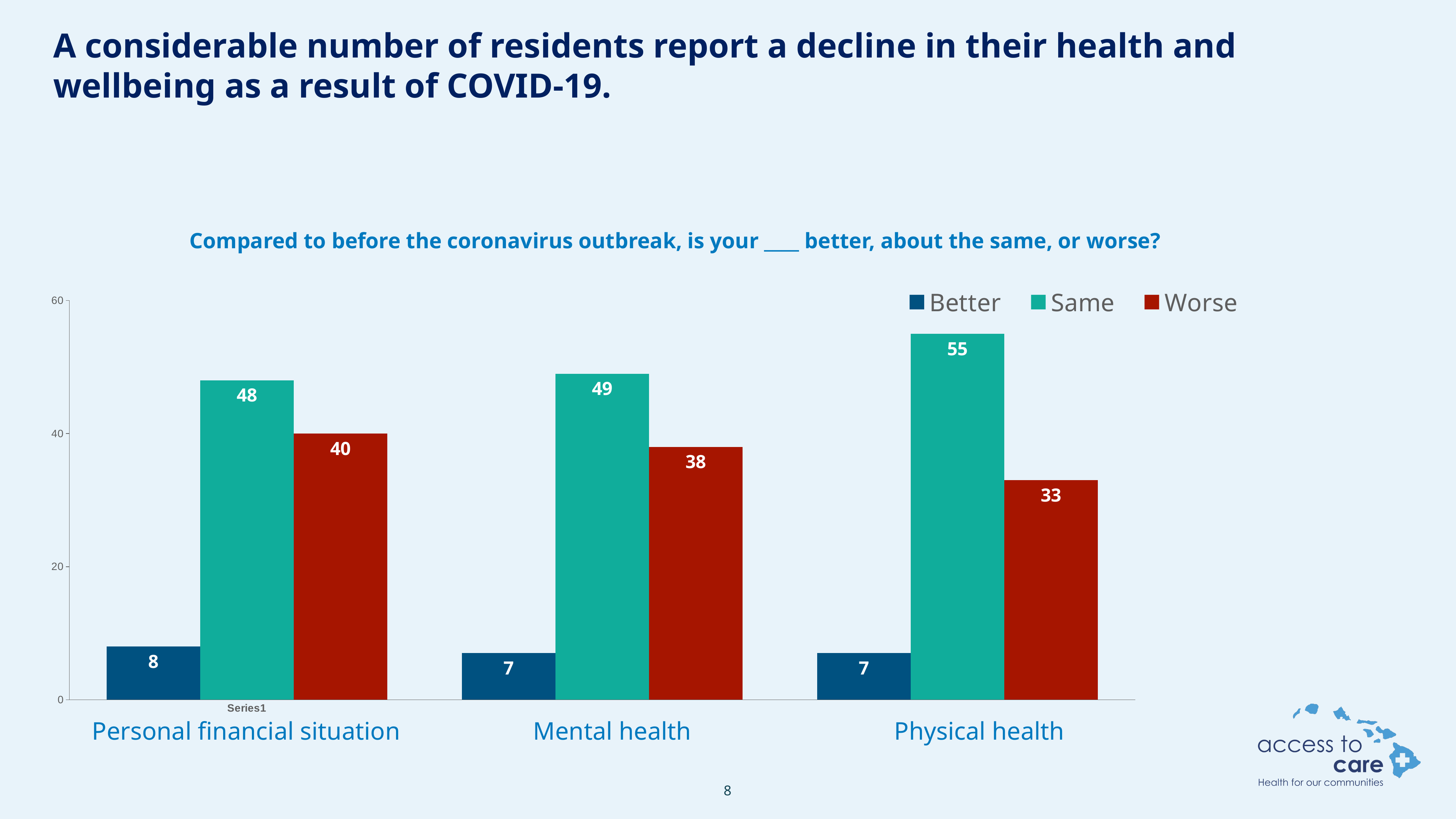
What is the value for Worse for Personal financial situation? 40 Is the Worse value for Mental health greater or less than 40? less What kind of chart is shown on the slide? bar chart How many series does the legend list? 3 How many categories are shown on the x axis? 3 What is the value for Better for Physical health? 7 What is the difference between the Same and Worse values for Physical health? 22 Which is larger for Mental health: the Same value or the Worse value? Same Which category has the lowest Worse value? Physical health Which colour represents the Worse series in the legend? red Which category has the highest Same value? Physical health What is the value for Same for Mental health? 49